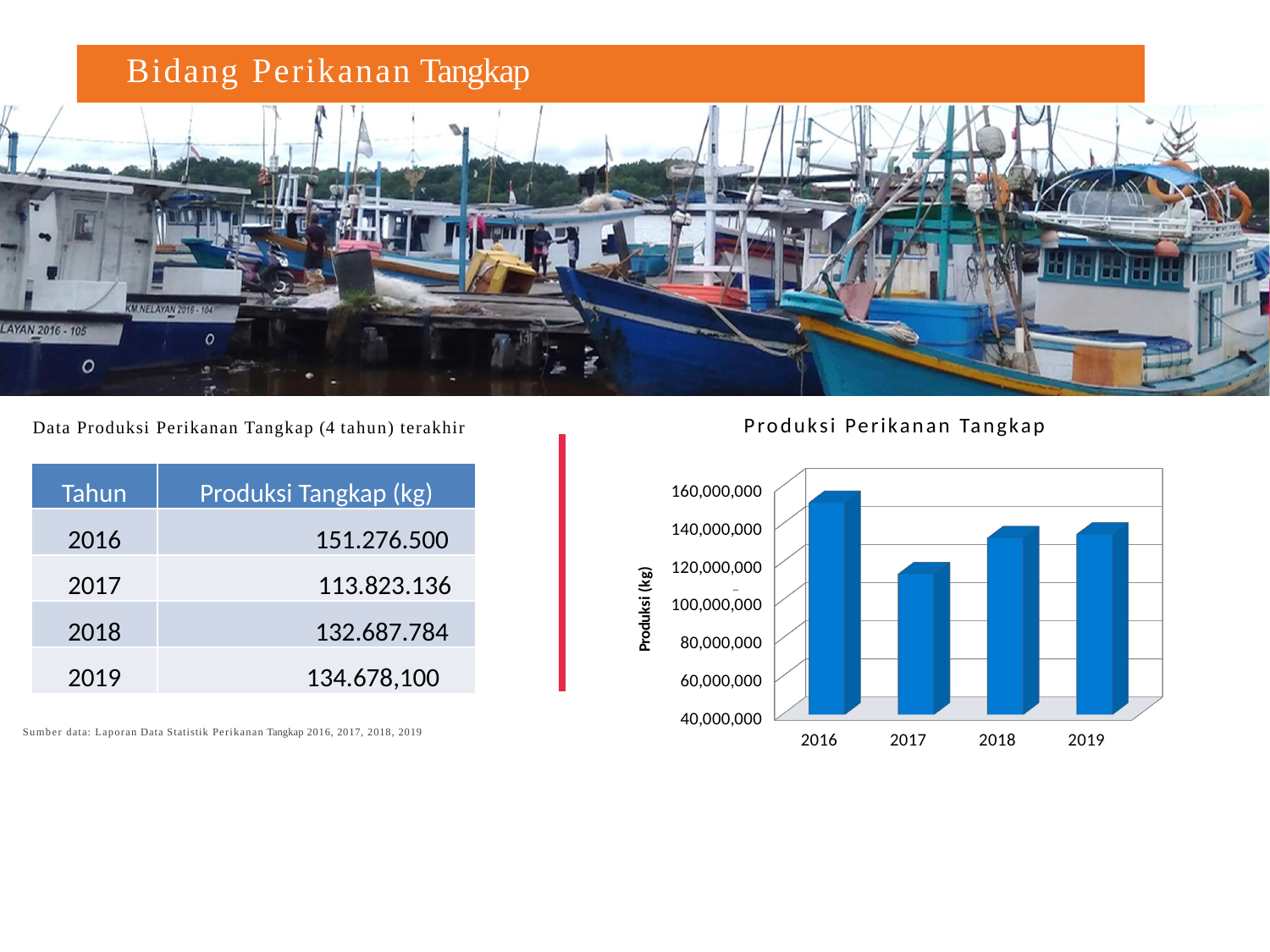
What is the label on the vertical axis of the "Produksi Perikanan Tangkap" chart? Produksi (kg) In the "Produksi Perikanan Tangkap" chart, is the value for 2019 greater or less than 140,000,000? less How many years are plotted on the "Produksi Perikanan Tangkap" chart? 4 In the "Produksi Perikanan Tangkap" chart, is the value for 2016 greater or less than 140,000,000? greater In the "Produksi Perikanan Tangkap" chart, is the value for 2018 greater or less than 120,000,000? greater In the "Produksi Perikanan Tangkap" chart, does the value rise or fall from 2016 to 2017? fall What kind of chart is shown under the title "Produksi Perikanan Tangkap"? bar chart In the "Produksi Perikanan Tangkap" chart, which year has the larger value, 2016 or 2017? 2016 Which year has the highest bar in the "Produksi Perikanan Tangkap" chart? 2016 In the "Produksi Perikanan Tangkap" chart, which year has the larger value, 2017 or 2018? 2018 Which year has the lowest bar in the "Produksi Perikanan Tangkap" chart? 2017